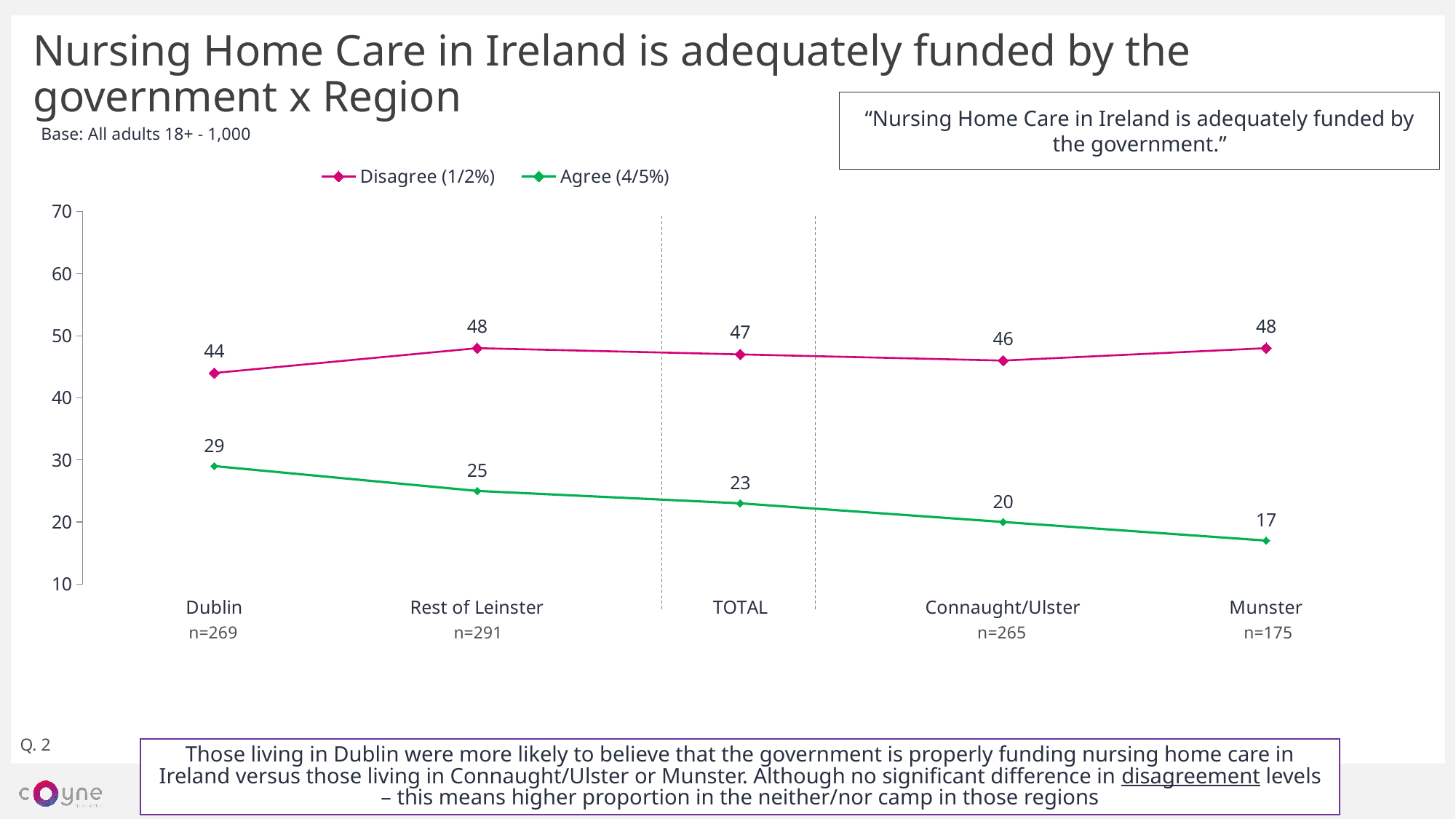
Is the Disagree (1/2%) value for Munster greater or less than 40? greater How many categories are shown on the x axis? 5 What kind of chart is shown on the slide? Line chart What is the Agree (4/5%) value for TOTAL? 23 What is the Disagree (1/2%) value for Dublin? 44 How many series does the legend list? 2 Does the Agree (4/5%) series rise or fall from Dublin to Munster? Fall What is the Agree (4/5%) value for Munster? 17 Which category has the lowest Disagree (1/2%) value? Dublin Which category has the highest Agree (4/5%) value? Dublin Which is larger: the Agree (4/5%) value for Dublin or for Rest of Leinster? Dublin What is the difference between the Disagree (1/2%) and Agree (4/5%) values for Connaught/Ulster? 26